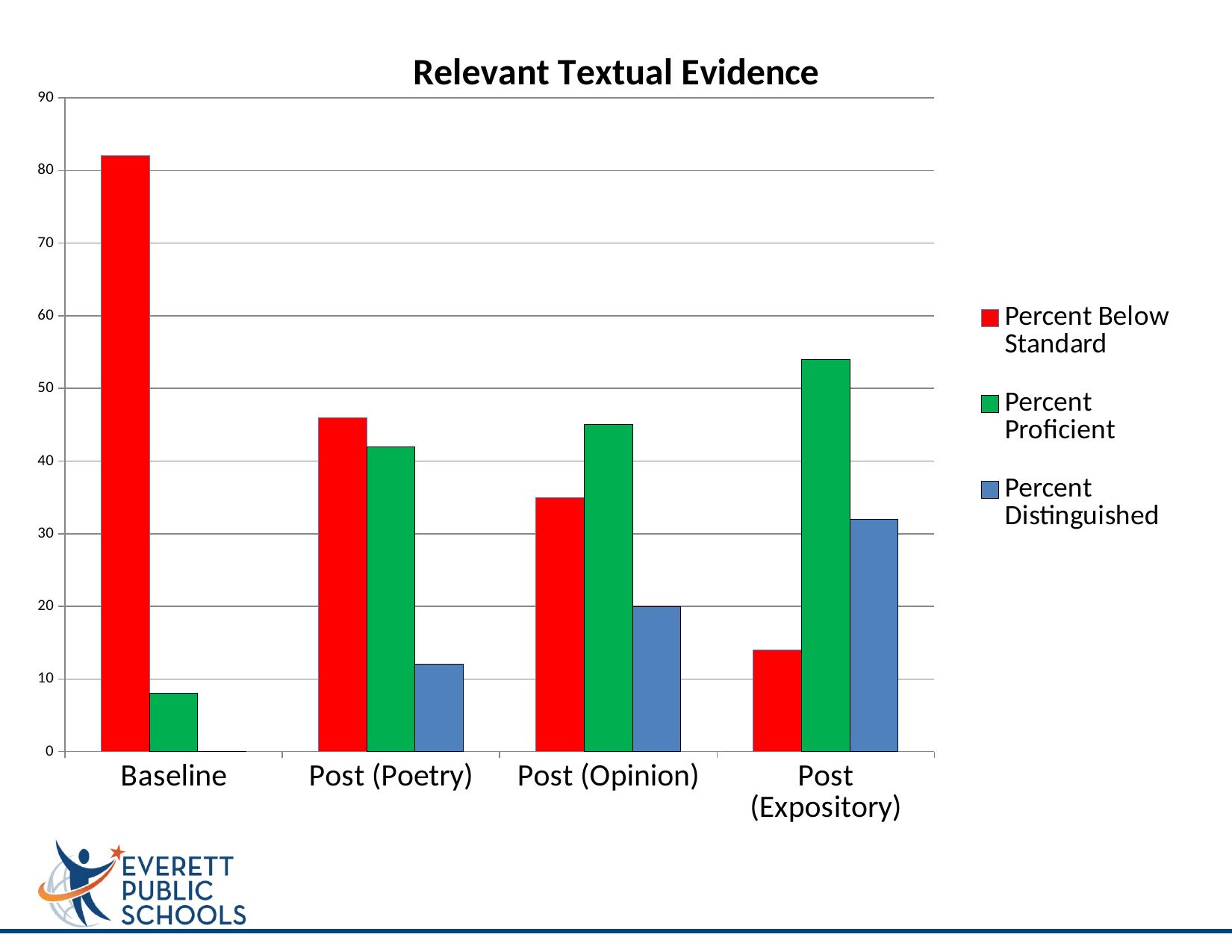
What type of chart is shown on the slide? bar chart Is the value for Percent Distinguished at Post (Poetry) greater or less than 10? greater How many series does the legend list? 3 Which is larger at Post (Opinion): Percent Below Standard or Percent Proficient? Percent Proficient Which category has the highest Percent Distinguished? Post (Expository) Does Percent Below Standard rise or fall across the categories from Baseline to Post (Expository)? fall Which category has the highest Percent Below Standard? Baseline Which category has the lowest Percent Below Standard? Post (Expository) Is the value for Percent Proficient at Post (Expository) greater or less than 50? greater Is the value for Percent Below Standard at Baseline greater or less than 80? greater What is the title of the chart? Relevant Textual Evidence How many categories are shown on the x axis? 4